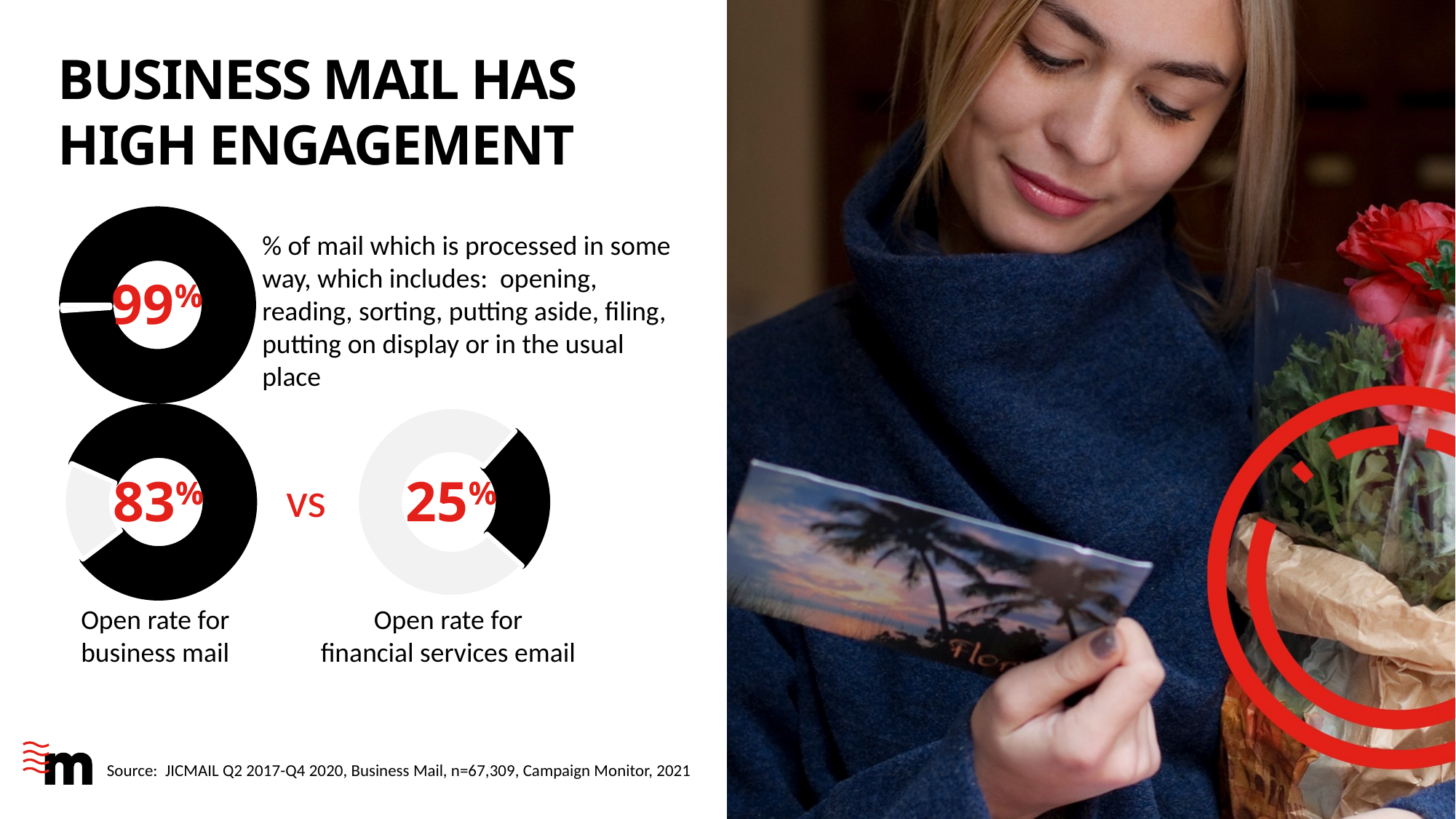
Of the three donut charts on the slide, which shows the highest value? % of mail which is processed in some way In the bottom-left donut chart, what is the open rate for business mail? 83% How many donut charts are shown on the slide? 3 In the top donut chart, what percentage of mail is processed in some way? 99% What colour is the filled portion of the donut charts? Black Of the three donut charts on the slide, which shows the lowest value? Open rate for financial services email What type of chart is used to show the 83% open rate for business mail? Donut chart Comparing the two bottom donut charts, which has the higher open rate: business mail or financial services email? Business mail In the bottom-right donut chart, what is the open rate for financial services email? 25% What is the difference between the open rate for business mail and the open rate for financial services email? 58% What is the title of the slide containing the donut charts? BUSINESS MAIL HAS HIGH ENGAGEMENT What is the difference between the percentage of mail processed in some way (top chart) and the open rate for business mail (bottom-left chart)? 16%